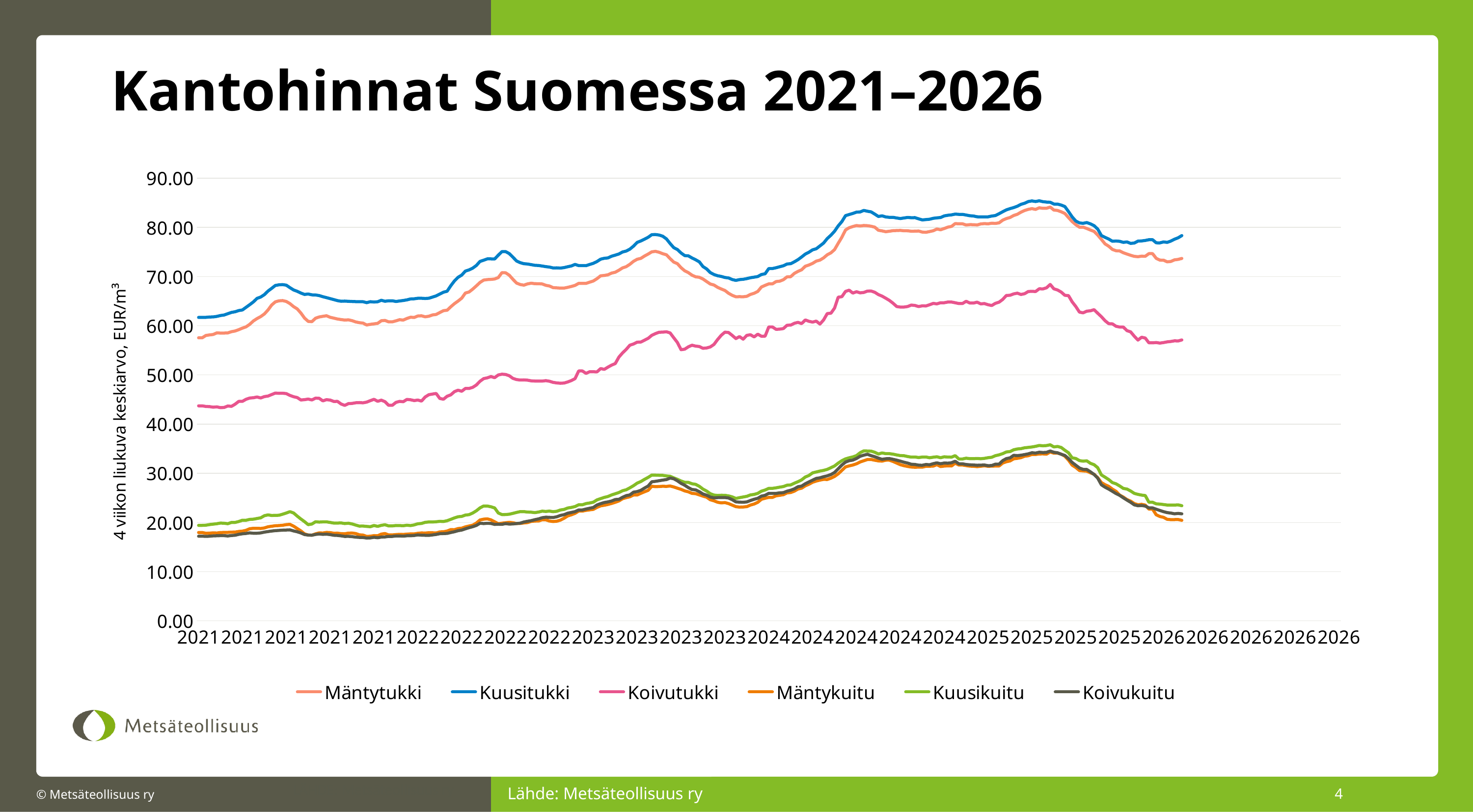
How many series does the legend list? 6 Which series has the highest values across the whole period? Kuusitukki Is the peak value of Kuusikuitu in 2025 greater or less than 30? greater What kind of chart is shown on the slide? line chart What is the title of the chart? Kantohinnat Suomessa 2021–2026 Is the peak value of Kuusitukki in 2025 greater or less than 80? greater Does the Koivutukki series rise or fall overall from the start of 2021 to 2026? rise What is the label of the vertical axis? 4 viikon liukuva keskiarvo, EUR/m³ Is the value for Mäntykuitu at the end of the series in 2026 greater or less than 30? less Which series is higher throughout the period, Koivutukki or Kuusikuitu? Koivutukki Which series is higher throughout the period, Kuusitukki or Mäntytukki? Kuusitukki